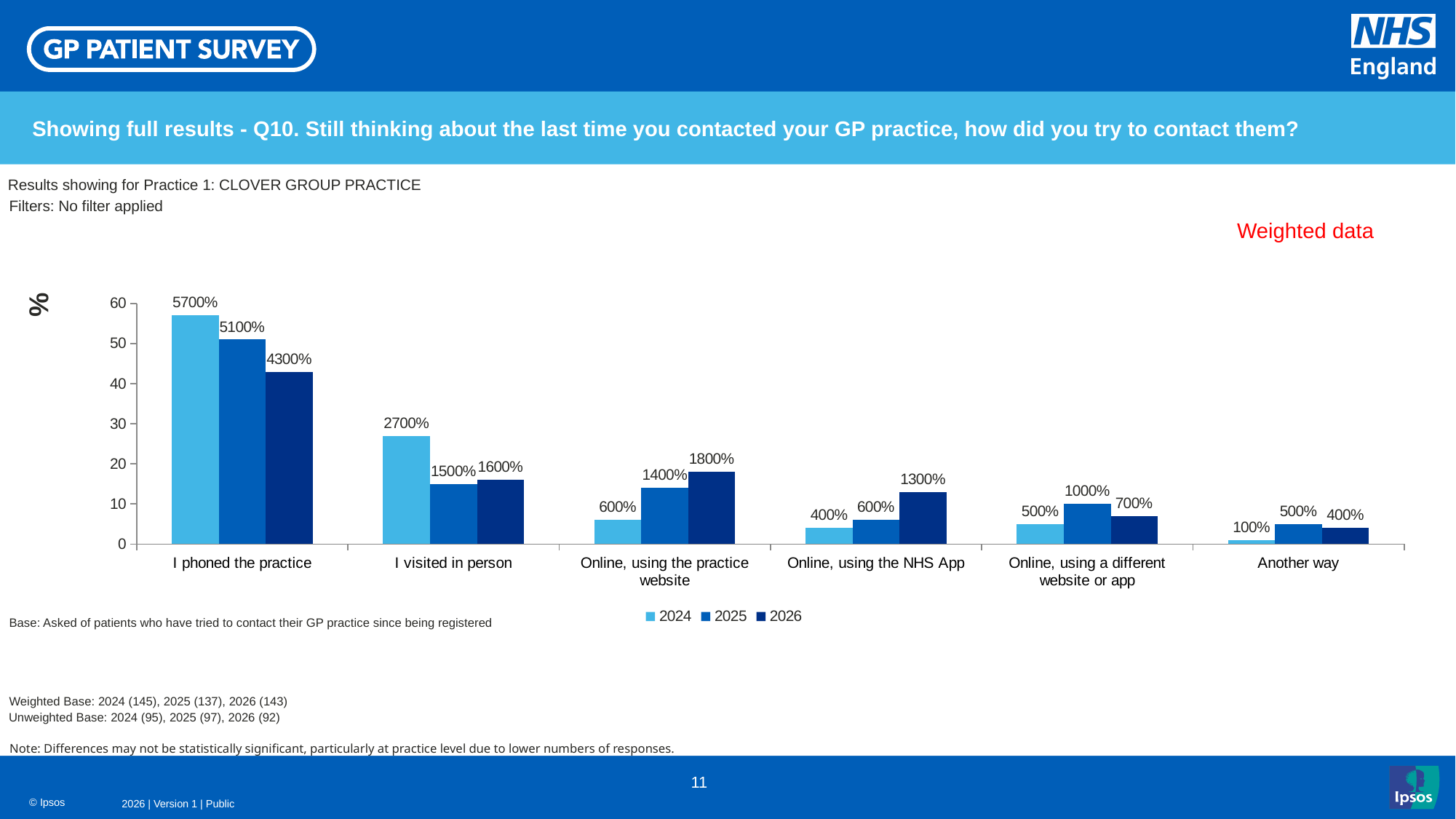
How many categories are shown on the x axis? 6 Which category has the lowest 2024 value? Another way What is the difference between the 2024 and 2025 values for 'I phoned the practice'? 600% What is the 2025 value for 'Online, using a different website or app'? 1000% How many series does the legend list? 3 What is the 2024 value for 'I phoned the practice'? 5700% What kind of chart is shown on the slide? Bar chart What is the 2024 value for 'Another way'? 100% Do the values for 'I phoned the practice' rise or fall from 2024 to 2026? Fall What is the 2026 value for 'Online, using the NHS App'? 1300% Which is larger for 'Online, using the practice website': the 2025 value or the 2026 value? 2026 Which category has the highest 2026 value? I phoned the practice